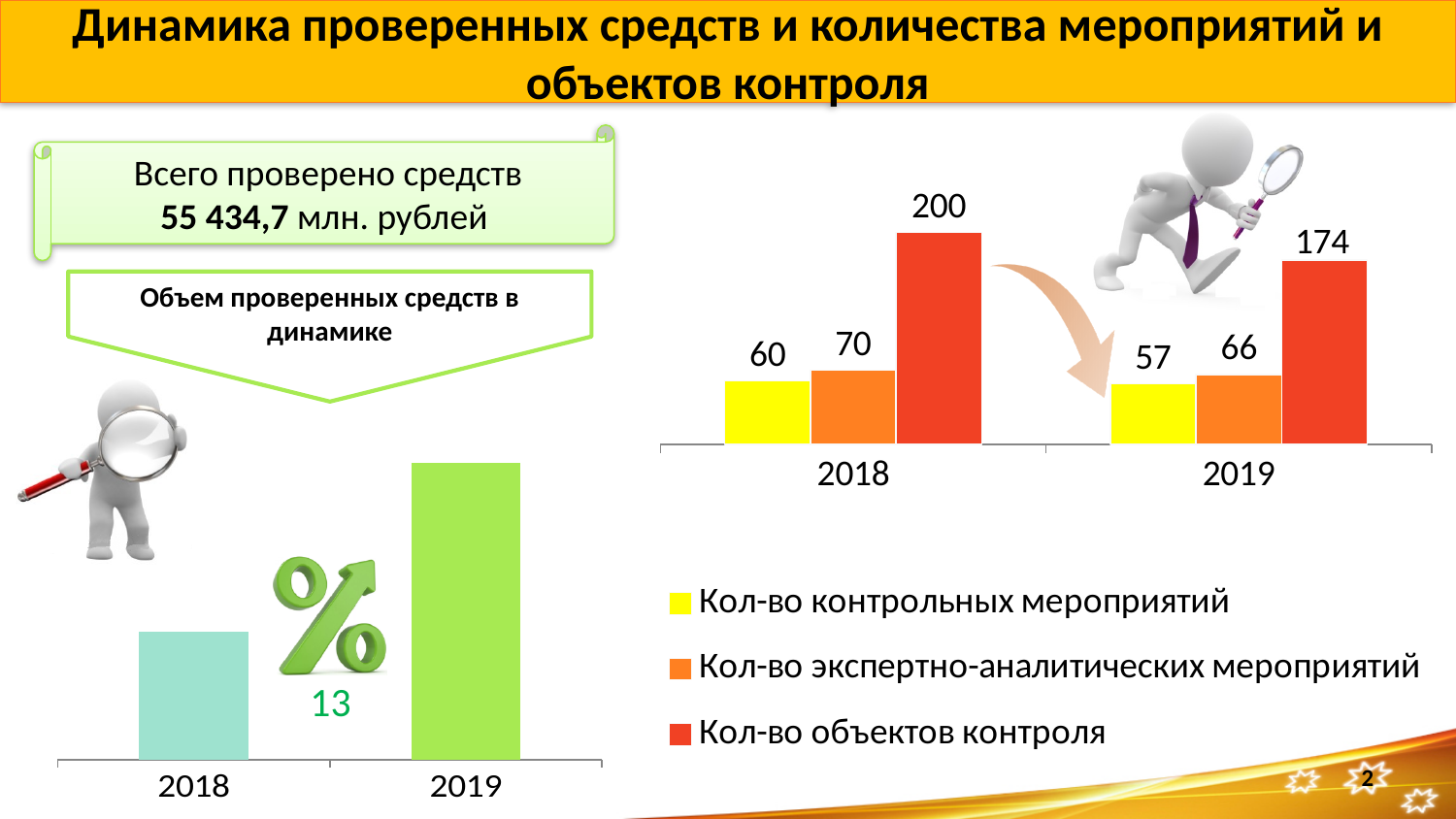
In the right-hand chart, what is the value for Кол-во контрольных мероприятий in 2019? 57 In the right-hand chart, which series has the highest value in 2019? Кол-во объектов контроля In the right-hand chart, what is the value for Кол-во экспертно-аналитических мероприятий in 2018? 70 In the right-hand chart, what is the difference between Кол-во объектов контроля in 2018 and in 2019? 26 In the right-hand chart, what is the value for Кол-во объектов контроля in 2019? 174 How many series does the legend of the right-hand chart list? 3 What kind of chart is the left-hand chart titled Объем проверенных средств в динамике? bar chart In the right-hand chart, do the values for Кол-во контрольных мероприятий rise or fall from 2018 to 2019? fall In the left-hand chart titled Объем проверенных средств в динамике, which year has the taller bar, 2018 or 2019? 2019 In the right-hand chart, which series has the lowest value in 2018? Кол-во контрольных мероприятий In the right-hand chart, what is the value for Кол-во объектов контроля in 2018? 200 In the right-hand chart, is Кол-во экспертно-аналитических мероприятий larger in 2018 or in 2019? 2018